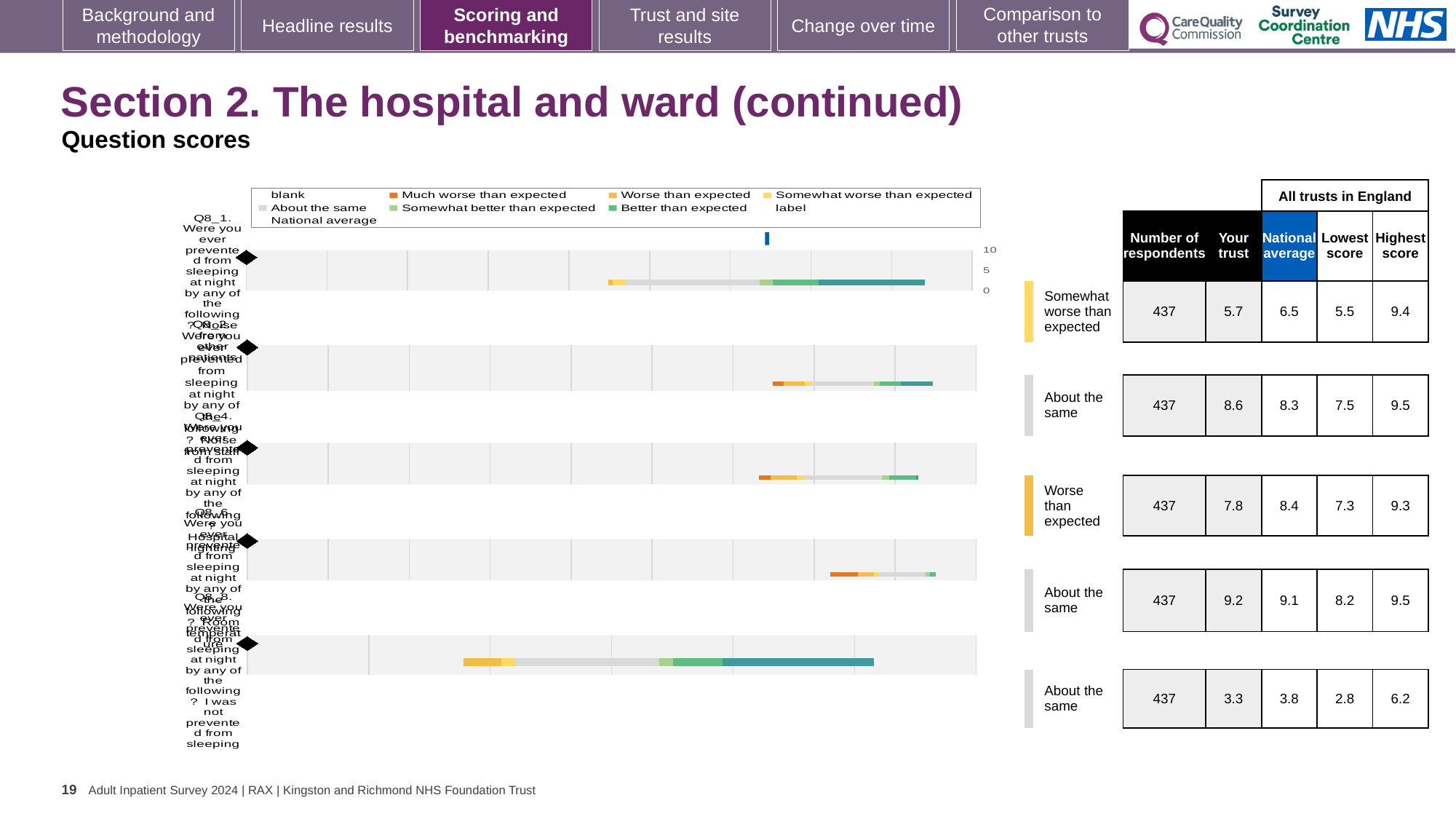
In the first row of the table, which is larger: the 'Your trust' score or the national average? National average What kind of chart is shown on the left of the slide? bar chart In the table, what is the 'Your trust' score for the first row? 5.7 In the table, what is the number of respondents for the first row? 437 Which row of the table has the lowest 'Your trust' score? The last row (3.3) In the table, what is the highest score for the last row? 6.2 In the first row of the table, what is the difference between the national average and the 'Your trust' score? 0.8 Which row of the table has the highest 'Your trust' score? The fourth row (9.2) In the table, what is the lowest score for the third row? 7.3 In the chart legend, which entry is shown in orange? Much worse than expected How many question rows (bars) does the chart on the left show? 5